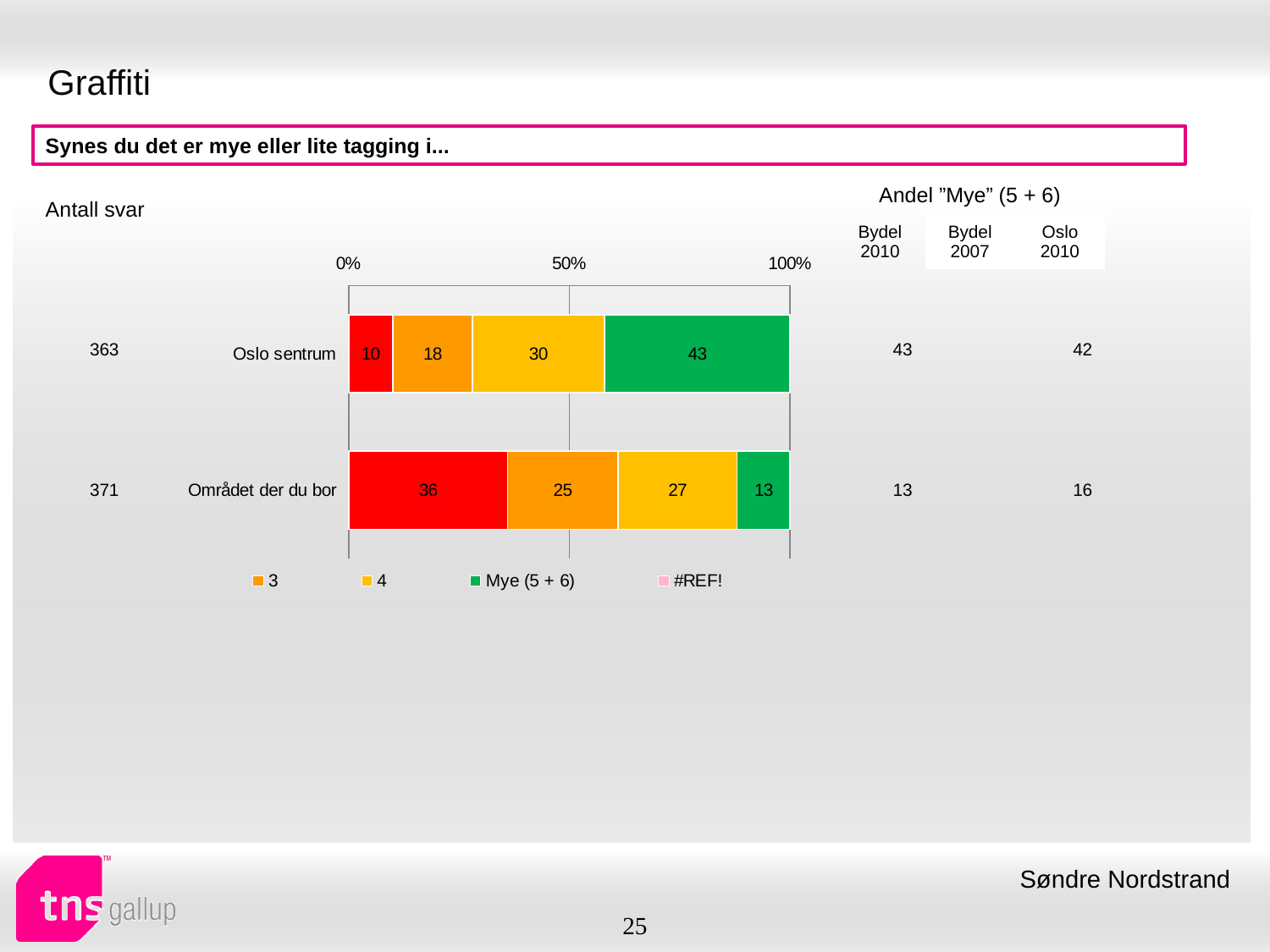
Is the "Mye (5 + 6)" value for Oslo sentrum greater or less than 50%? less Which category has the higher "Mye (5 + 6)" value, Oslo sentrum or Området der du bor? Oslo sentrum What is the value of the "Mye (5 + 6)" segment for Området der du bor? 13 How many categories are plotted in the chart? 2 What kind of chart is shown on the slide? Stacked bar chart What question is shown as the chart's heading? Synes du det er mye eller lite tagging i... What is the difference between the "Mye (5 + 6)" values for Oslo sentrum and Området der du bor? 30 What is the value of the "3" segment for Området der du bor? 25 What is the value of the "4" segment for Oslo sentrum? 30 What is the value of the "3" segment for Oslo sentrum? 18 What is the value of the "Mye (5 + 6)" segment for Oslo sentrum? 43 How many entries does the chart legend list? 4